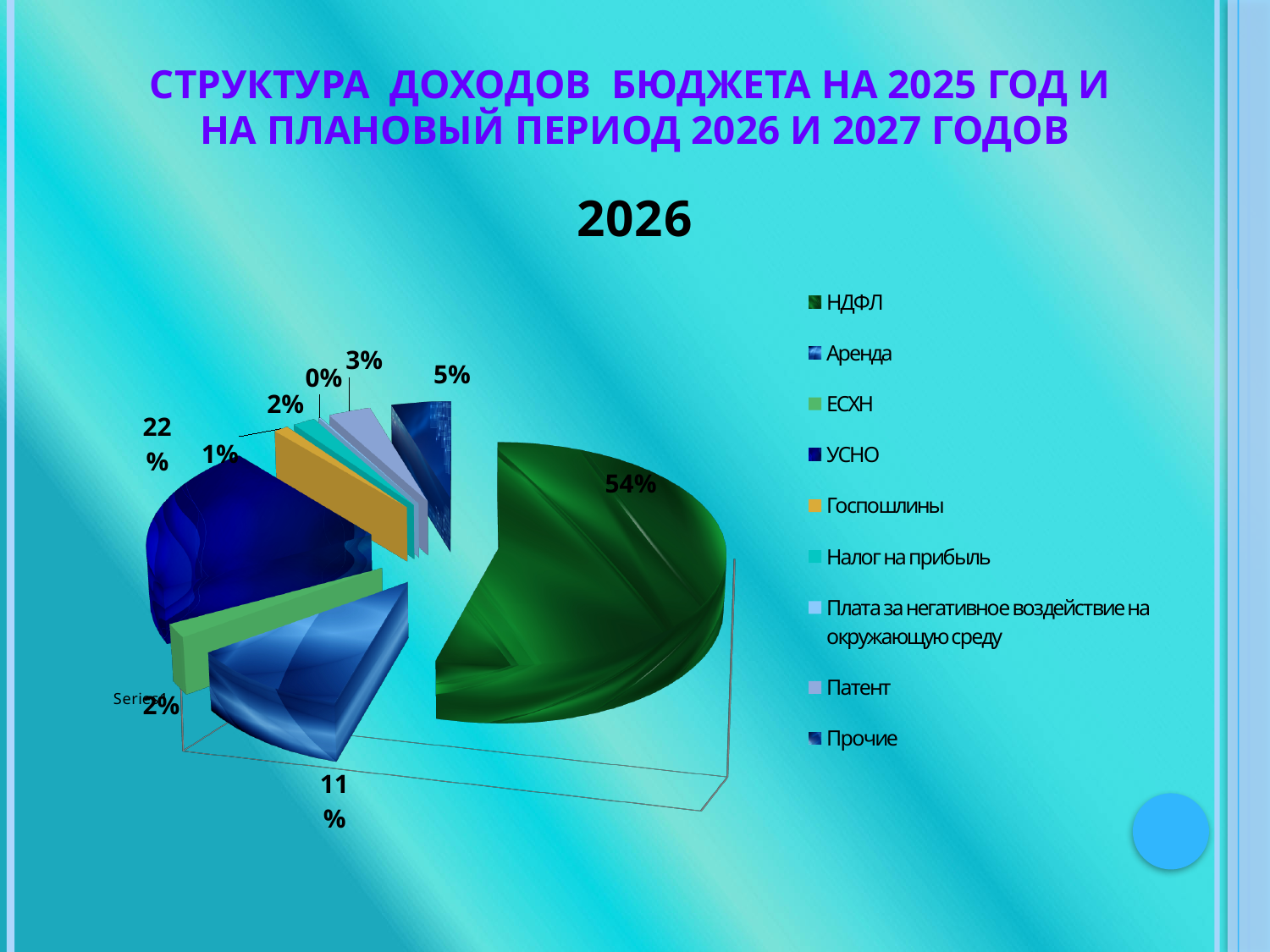
What kind of chart is shown on the slide? pie chart How many categories does the legend list? 9 What is the value for Аренда? 11% What is the difference between the shares of УСНО and Аренда? 11 percentage points Which legend entry is listed first? НДФЛ What is the chart's title? 2026 Which is larger, the share of Аренда or the share of УСНО? УСНО What is the smallest percentage shown as a data label on the chart? 0% What is the value for УСНО? 22% What share of the pie does НДФЛ have? 54% Which category has the largest slice of the pie? НДФЛ What is the difference between the shares of НДФЛ and УСНО? 32 percentage points